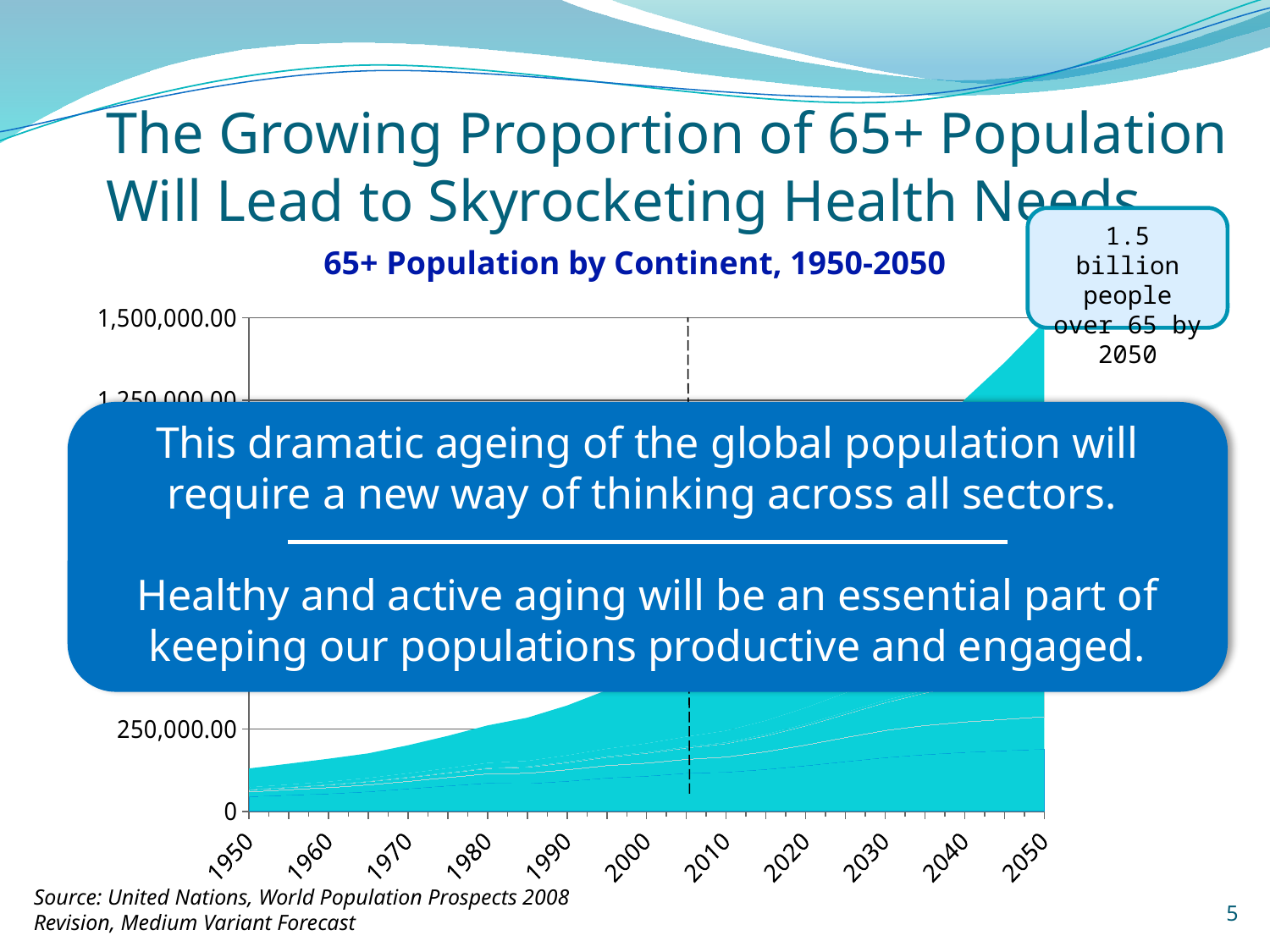
According to the callout on the chart, how many people will be over 65 by 2050? 1.5 billion What kind of chart is shown on the slide? Stacked area chart Which year has the larger total 65+ population in the chart, 1950 or 2050? 2050 Is the total value for 1950 greater or less than 250,000.00? less What is the title of the chart on the slide? 65+ Population by Continent, 1950-2050 How many year labels are shown along the x axis of the chart? 11 Is the total value for 2050 greater or less than 1,250,000.00? greater Does the total 65+ population rise or fall from 1950 to 2050 in the chart? Rise